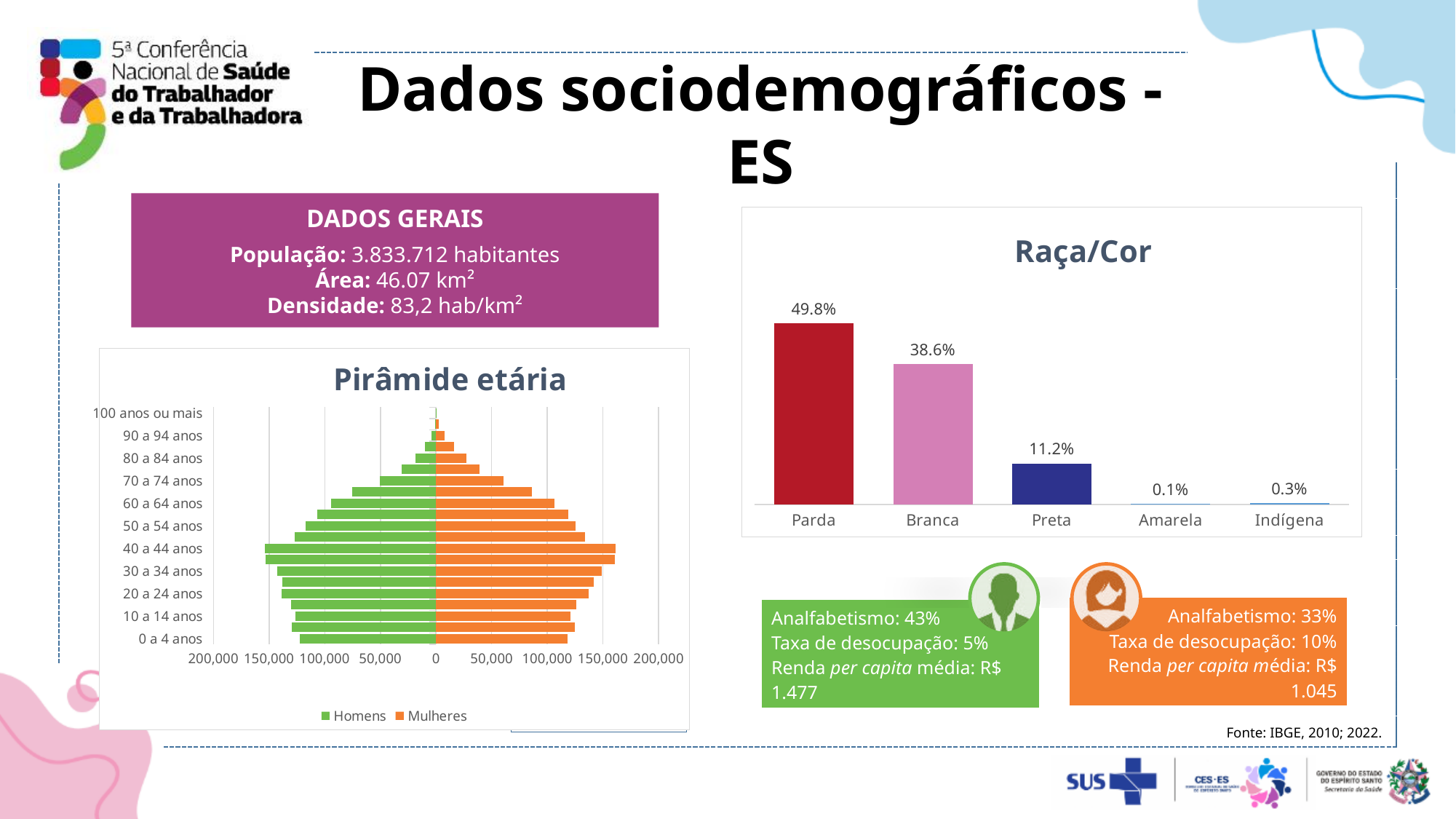
In the Raça/Cor chart, which category has the lowest value? Amarela In the Raça/Cor chart, what is the value for Parda? 49.8% In the Raça/Cor chart, which is larger, the value for Indígena or the value for Amarela? Indígena How many categories are shown in the Raça/Cor chart? 5 In the Raça/Cor chart, what is the value for Preta? 11.2% In the Raça/Cor chart, what is the difference between the values for Parda and Branca? 11.2% In the Raça/Cor chart, which category has the highest value? Parda In the Pirâmide etária chart, is the Homens value for 80 a 84 anos greater or less than 50,000? less What kind of chart is the Raça/Cor chart? Bar chart How many series does the legend of the Pirâmide etária chart list? 2 In the Pirâmide etária chart, is the Homens value for 40 a 44 anos greater or less than 100,000? greater In the Pirâmide etária chart, which series is shown in orange? Mulheres